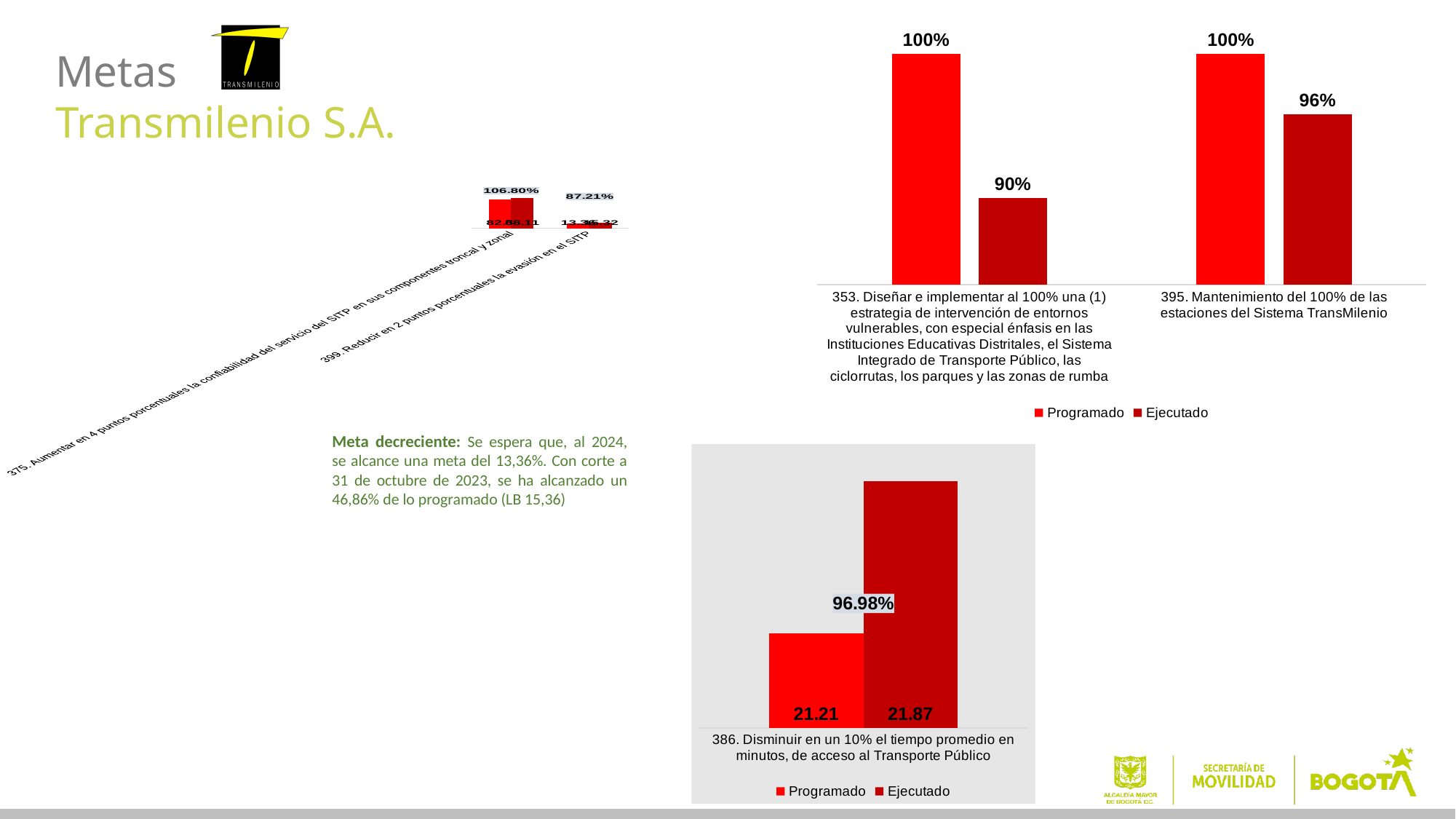
In the top-right chart, what is the Ejecutado value for goal 395 (Mantenimiento del 100% de las estaciones del Sistema TransMilenio)? 96% What are the two legend entries of the bottom chart for goal 386? Programado and Ejecutado In the bottom chart for goal 386, which is larger, Programado or Ejecutado? Ejecutado In the top-right chart, what is the difference between the Programado and Ejecutado values for goal 353? 10% What kind of chart is the top-right chart? Bar chart In the top-right chart, what is the Ejecutado value for goal 353 (Diseñar e implementar al 100% una (1) estrategia de intervención de entornos vulnerables)? 90% In the bottom chart for goal 386, what is the Ejecutado value? 21.87 How many series does the legend of the top-right chart list? 2 In the top-right chart, which goal has the higher Ejecutado value, 353 or 395? 395 In the top-right chart, what is the Programado value for goal 395? 100% In the bottom chart for goal 386 (Disminuir en un 10% el tiempo promedio en minutos, de acceso al Transporte Público), what is the Programado value? 21.21 In the bottom chart for goal 386, what percentage label is shown between the two bars? 96.98%